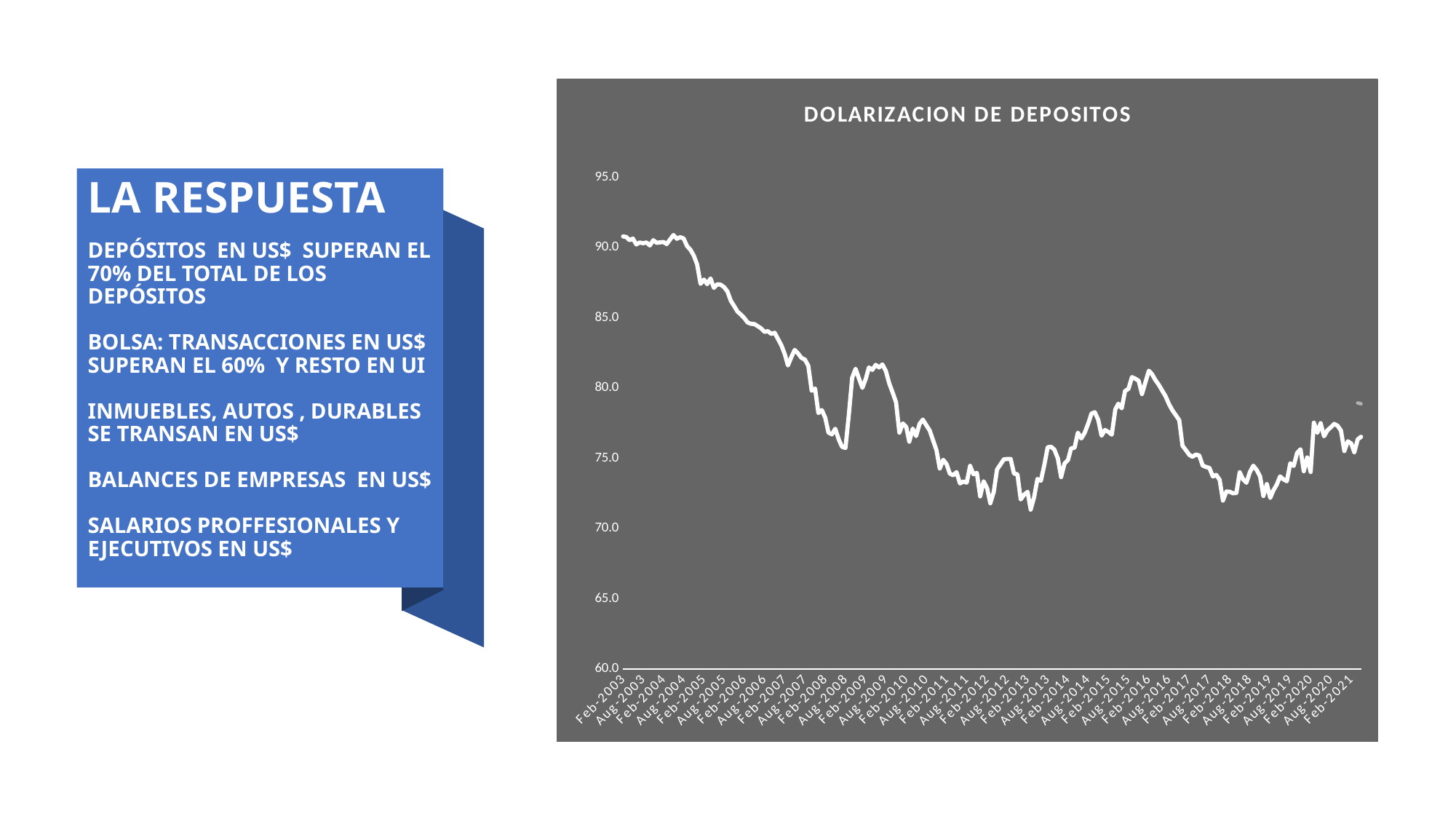
What is the title of the chart? DOLARIZACION DE DEPOSITOS Is the value for Feb-2008 greater or less than 85.0? less What kind of chart is shown on the slide? line chart Which is larger, the value for Feb-2013 or the value for Aug-2016? Aug-2016 Is the value for Feb-2003 greater or less than 85.0? greater What are the first and last labels on the x axis of the chart? Feb-2003 and Feb-2021 Is the value for Feb-2013 greater or less than 75.0? less Overall, does the line in the DOLARIZACION DE DEPOSITOS chart rise or fall from Feb-2003 to Feb-2021? fall Which is larger, the value for Feb-2003 or the value for Feb-2021? Feb-2003